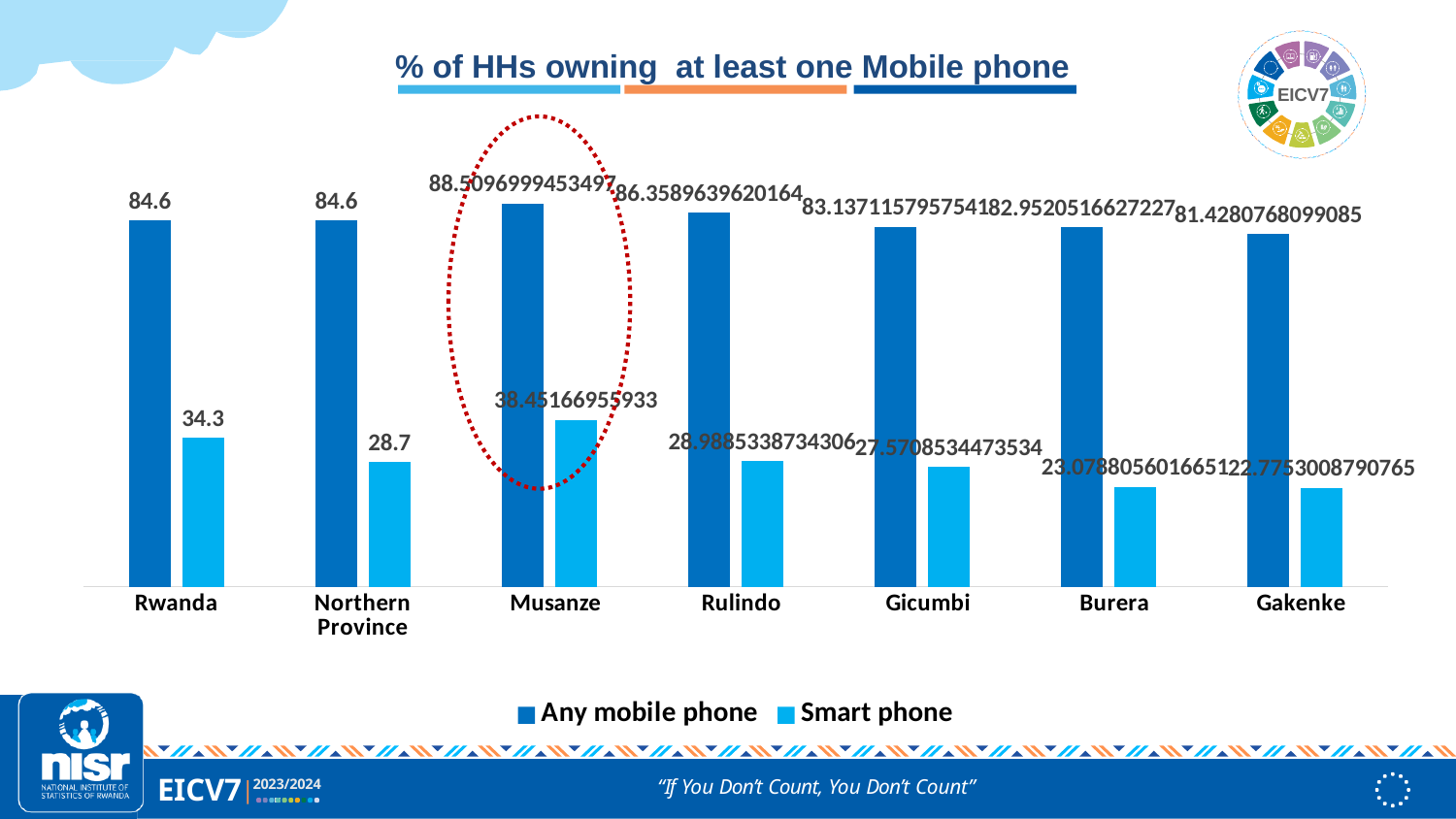
How much higher is the smart phone value for Rwanda than for Northern Province? 5.6 How many series does the legend list? 2 What is the difference between the any mobile phone value and the smart phone value for Rwanda? 50.3 Which has a larger smart phone value, Rwanda or Northern Province? Rwanda What type of chart is shown on the slide? Bar chart What is the smart phone value for Rwanda? 34.3 Which category has the highest smart phone value? Musanze How many categories are shown on the x axis? 7 Which district has the highest value for any mobile phone ownership? Musanze What is the smart phone value for Northern Province? 28.7 What percentage of households in Rwanda own any mobile phone? 84.6 Which category has the lowest value for any mobile phone ownership? Gakenke